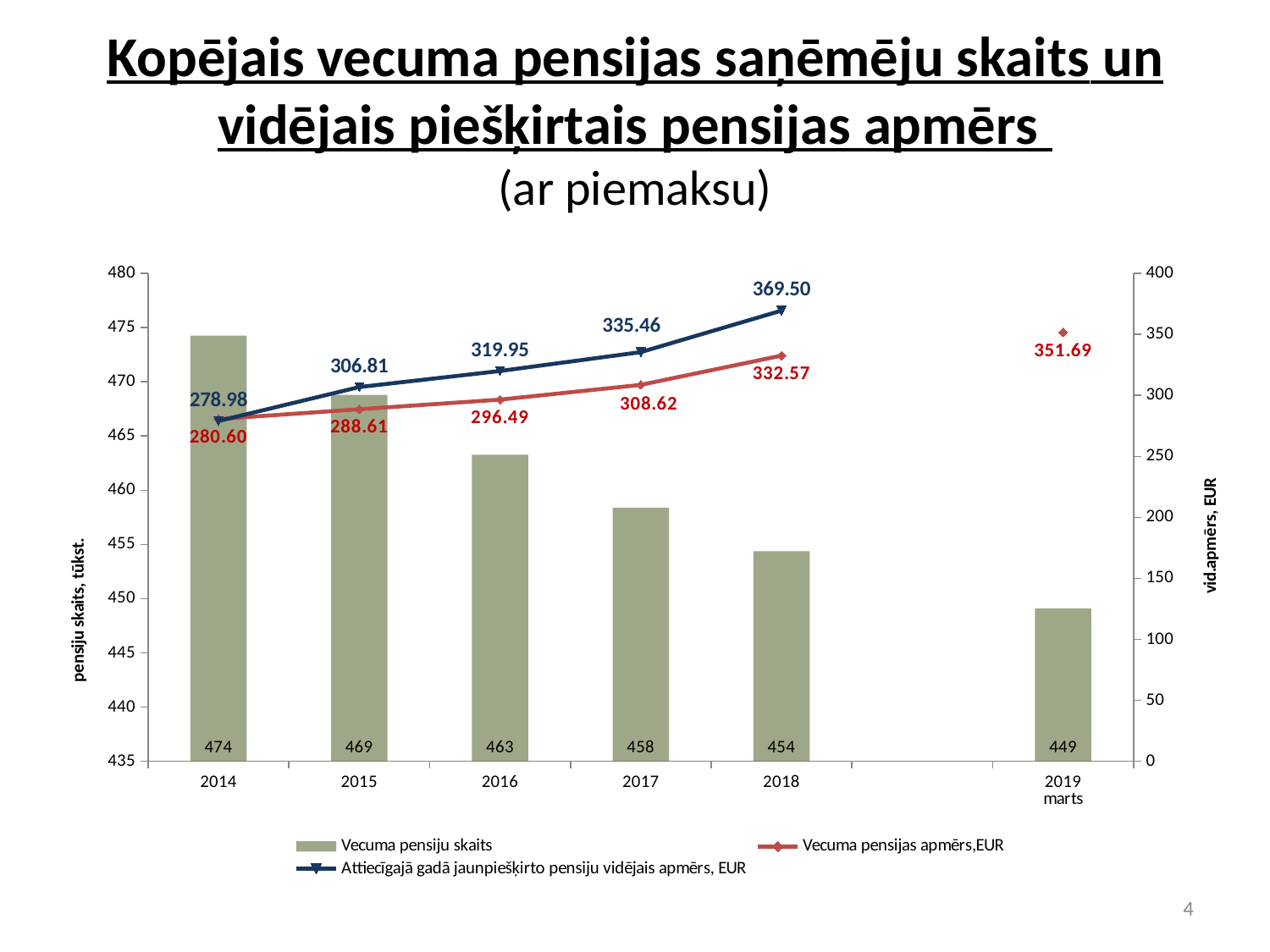
Which year has the lowest value for Vecuma pensiju skaits? 2019 marts Which is larger in 2017: Vecuma pensijas apmērs, EUR or Attiecīgajā gadā jaunpiešķirto pensiju vidējais apmērs, EUR? Attiecīgajā gadā jaunpiešķirto pensiju vidējais apmērs, EUR What is the value of Attiecīgajā gadā jaunpiešķirto pensiju vidējais apmērs, EUR for 2016? 319.95 What is the value of Vecuma pensijas apmērs, EUR for 2018? 332.57 What is the difference between the Vecuma pensiju skaits values for 2014 and 2018? 20 What is the value of Vecuma pensijas apmērs, EUR for 2019 marts? 351.69 How many series does the legend list? 3 Which year has the highest value for Attiecīgajā gadā jaunpiešķirto pensiju vidējais apmērs, EUR? 2018 How many bars are shown for Vecuma pensiju skaits? 6 How does Vecuma pensiju skaits change from 2014 to 2019 marts? It falls What is the value of Vecuma pensiju skaits for 2014? 474 What is the label of the right-hand vertical axis? vid.apmērs, EUR